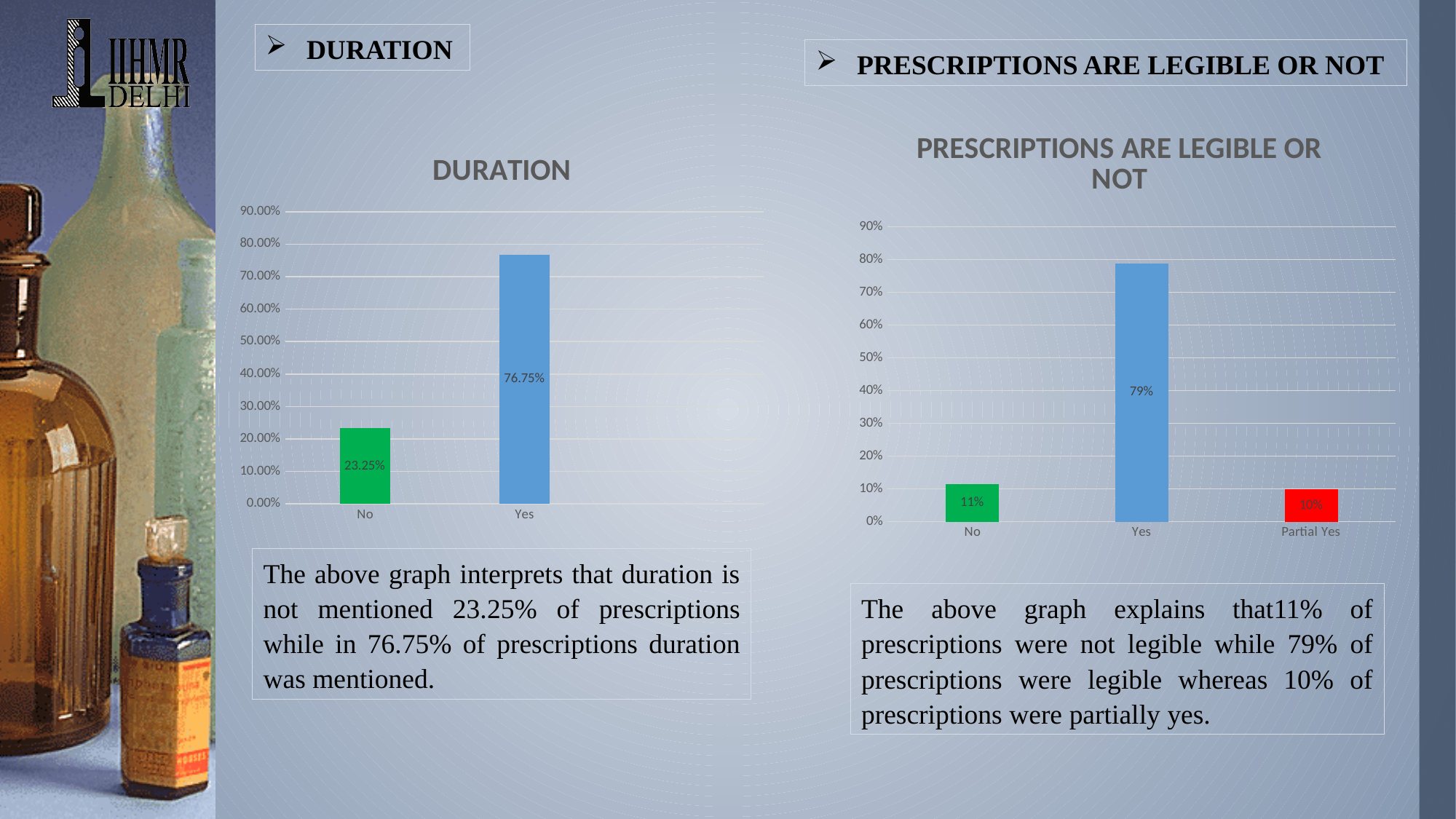
In the DURATION chart, what is the value for No? 23.25% In the DURATION chart, how many categories are shown on the x axis? 2 In the DURATION chart, what is the value for Yes? 76.75% In the PRESCRIPTIONS ARE LEGIBLE OR NOT chart, which category has the lowest value? Partial Yes In the PRESCRIPTIONS ARE LEGIBLE OR NOT chart, how many categories are shown on the x axis? 3 In the PRESCRIPTIONS ARE LEGIBLE OR NOT chart, what is the value for Yes? 79% In the PRESCRIPTIONS ARE LEGIBLE OR NOT chart, which category has the highest value? Yes In the PRESCRIPTIONS ARE LEGIBLE OR NOT chart, what is the value for Partial Yes? 10% What kind of chart is the DURATION chart? bar chart In the DURATION chart, what is the difference between the Yes and No values? 53.50% In the PRESCRIPTIONS ARE LEGIBLE OR NOT chart, what is the difference between the Yes and No values? 68% In the PRESCRIPTIONS ARE LEGIBLE OR NOT chart, what colour is the Partial Yes bar? red